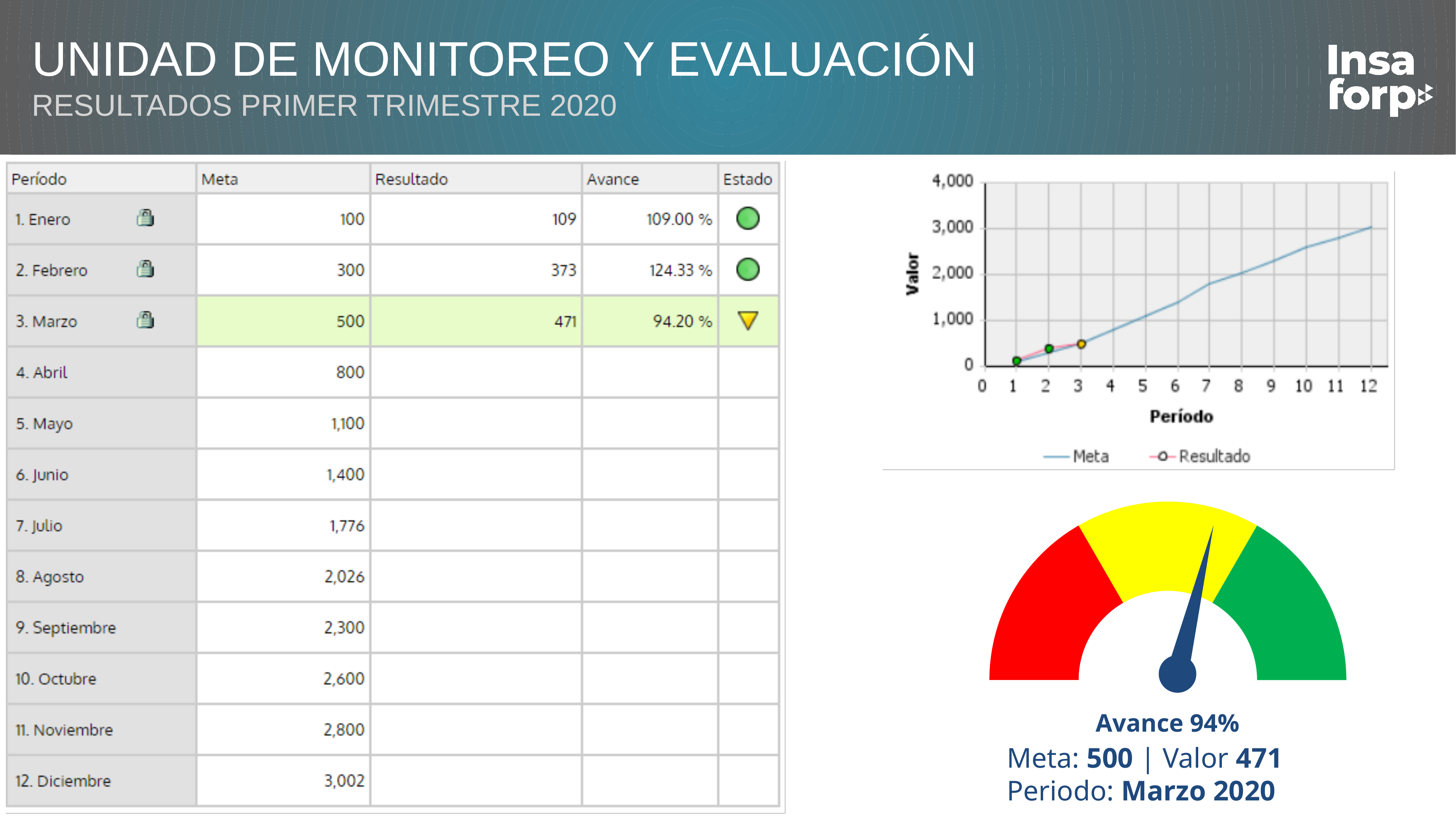
What Avance percentage is shown below the gauge chart? 94% In the line chart, is the Meta value at Período 7 greater or less than 1,000? greater How many Resultado points are plotted in the line chart? 3 In the line chart, is the Resultado value at Período 3 greater or less than 1,000? less What Meta value is shown below the gauge chart? 500 What kind of chart is the chart titled with axes 'Valor' and 'Período' on the right of the slide? line chart In the line chart, does the Meta series rise or fall as Período increases from 1 to 12? rise How many series does the legend of the line chart list? 2 What is the difference between the Meta (500) and the Valor (471) shown below the gauge chart? 29 In the line chart, which is larger: the Meta value at Período 12 or the Meta value at Período 1? Período 12 In the line chart, is the Meta value at Período 12 greater or less than 2,000? greater What are the two series named in the legend of the line chart? Meta and Resultado